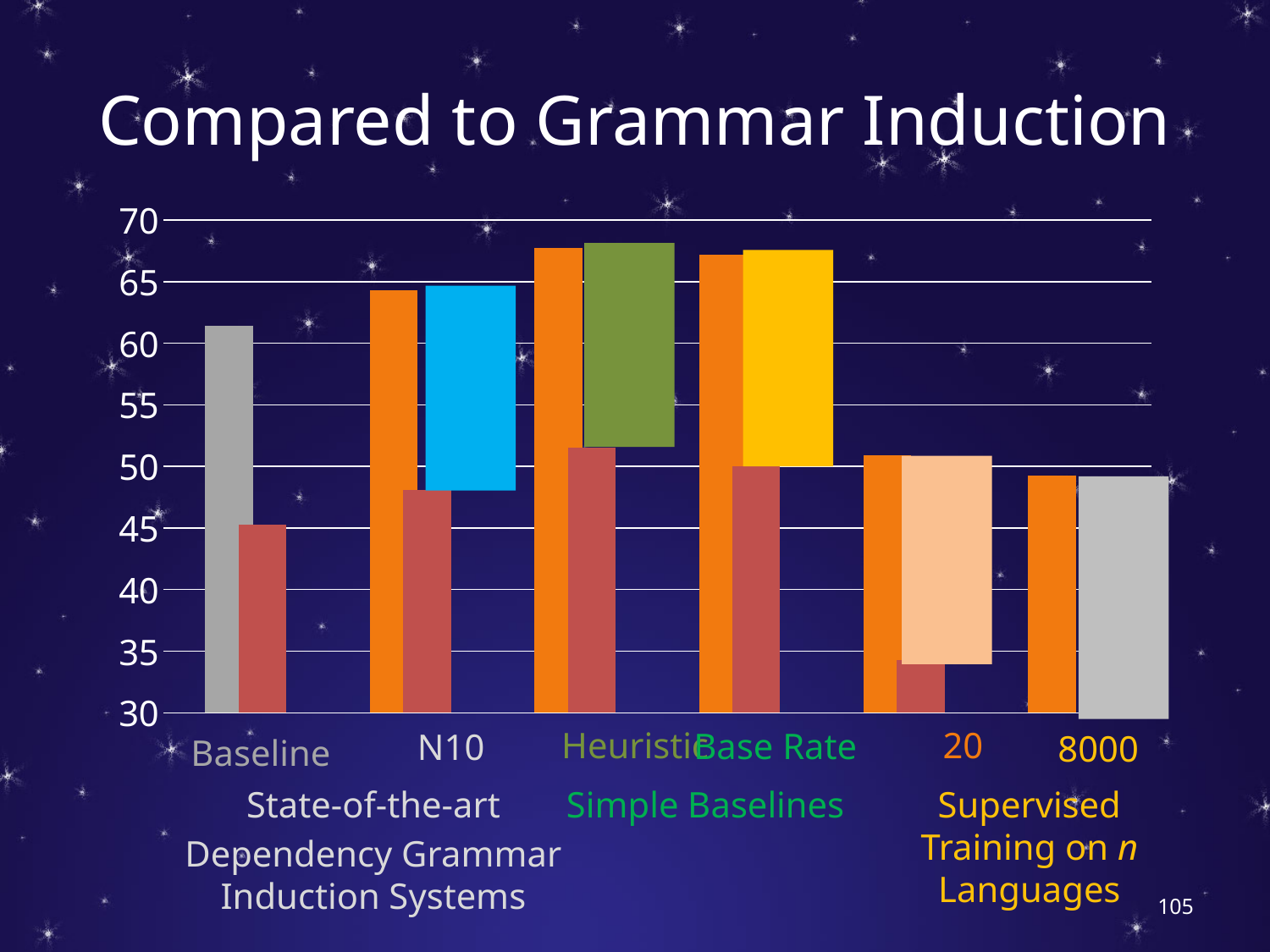
Is the value of the second (right) bar for 20 greater or less than 40? less Which group label on the chart covers the categories 20 and 8000? Supervised Training on n Languages Is the value of the second (right) bar for Baseline greater or less than 50? less Is the value of the first (left) bar for Baseline greater or less than 60? greater Which is larger: the first (left) bar for Heuristic or the first (left) bar for 20? Heuristic What kind of chart is shown on the slide? bar chart How many categories are shown along the x axis of the chart? 6 Which category has the lowest bar in the chart? 20 Which is larger: the first (left) bar for Baseline or the first (left) bar for N10? N10 What is the title of the chart? Compared to Grammar Induction